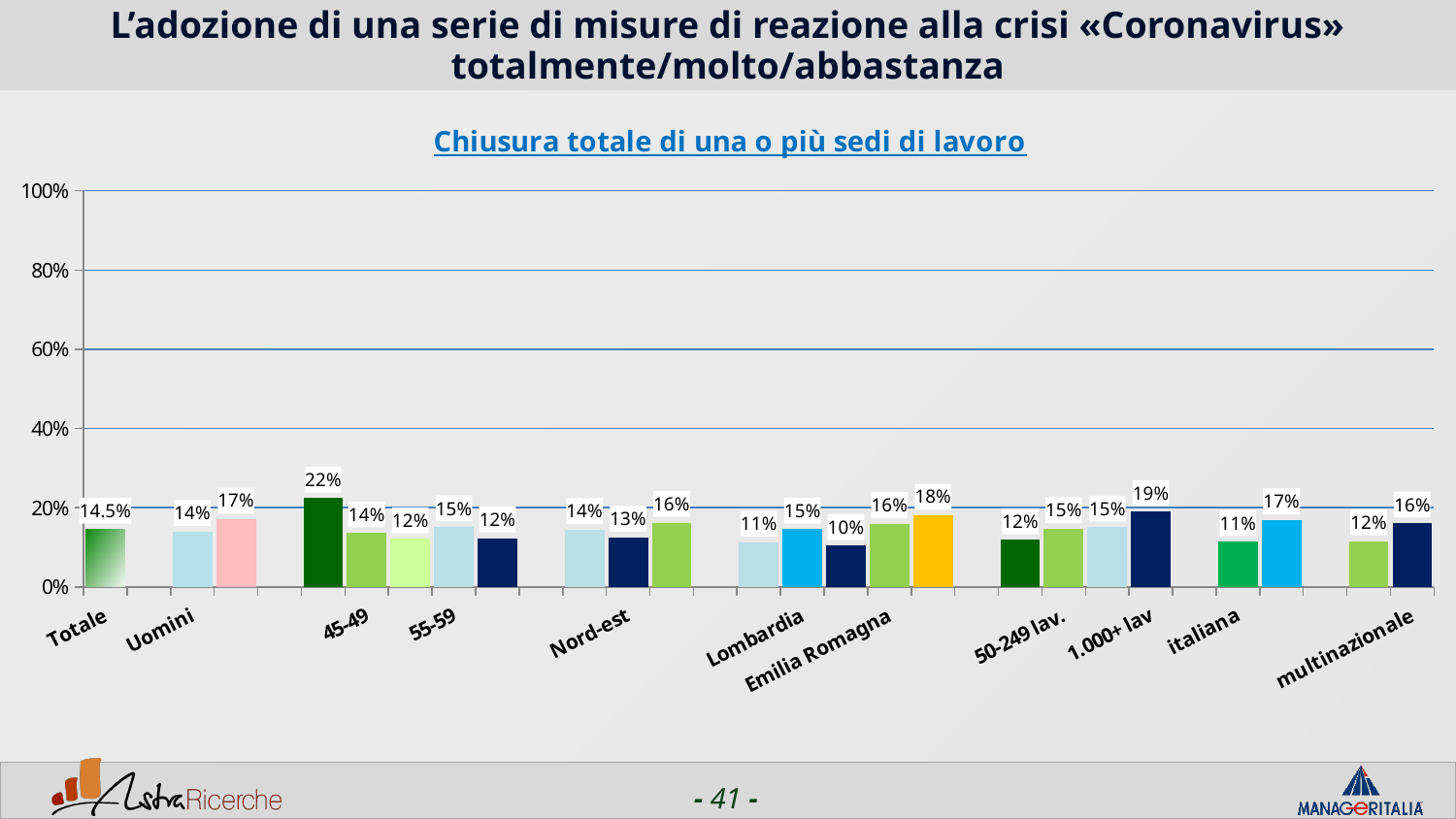
What is the value for 1.000+ lav? 19% Which is larger, the value for Totale or the value for Uomini? Totale Is the value for Totale greater or less than 40%? less What is the title of the chart? Chiusura totale di una o più sedi di lavoro What kind of chart is shown on the slide? bar chart What is the lowest value shown on the chart? 10% What is the value for Uomini? 14% What is the difference between the value for 1.000+ lav and the value for Uomini? 5 percentage points How many bars are plotted on the chart? 24 What is the maximum value shown on the vertical axis? 100% What is the value for Totale? 14.5% What is the highest value shown on the chart? 22%